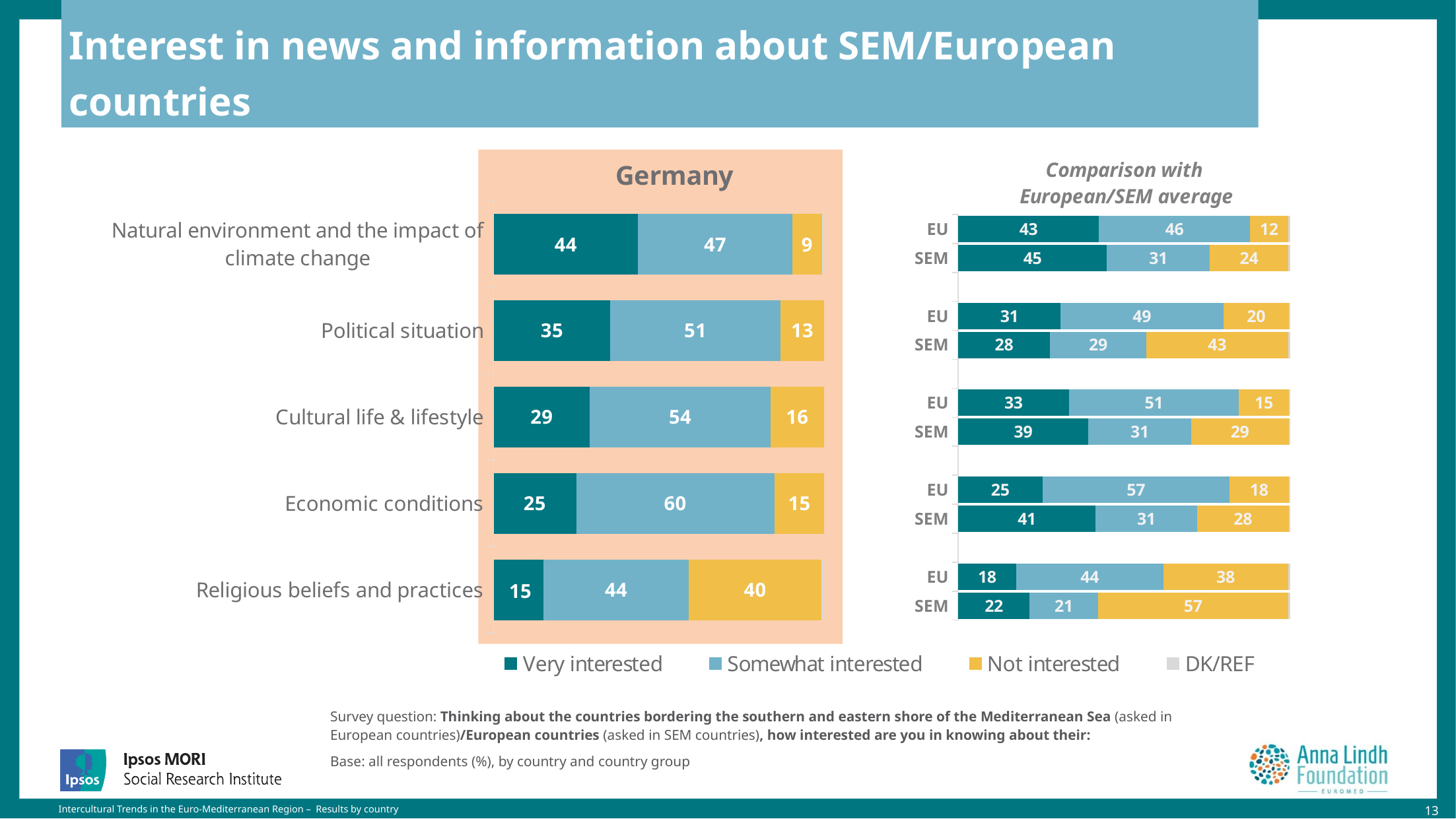
In the Germany chart, which is larger: the 'Not interested' value for cultural life & lifestyle or for political situation? Cultural life & lifestyle In the 'Comparison with European/SEM average' chart, what is the SEM 'Not interested' value for religious beliefs and practices? 57 In the Germany chart, what percentage is 'Very interested' in the natural environment and the impact of climate change? 44 In the Germany chart, which topic has the lowest 'Very interested' value? Religious beliefs and practices How many series does the legend list? 4 In the Germany chart, what is the 'Not interested' value for religious beliefs and practices? 40 In the 'Comparison with European/SEM average' chart, what is the EU 'Somewhat interested' value for economic conditions? 57 How many topics are shown in the Germany chart? 5 In the Germany chart, what is the 'Somewhat interested' value for economic conditions? 60 What type of chart is the Germany chart? Stacked bar chart In the Germany chart, what is the difference between the 'Somewhat interested' values for economic conditions and political situation? 9 In the Germany chart, which topic has the highest 'Very interested' value? Natural environment and the impact of climate change